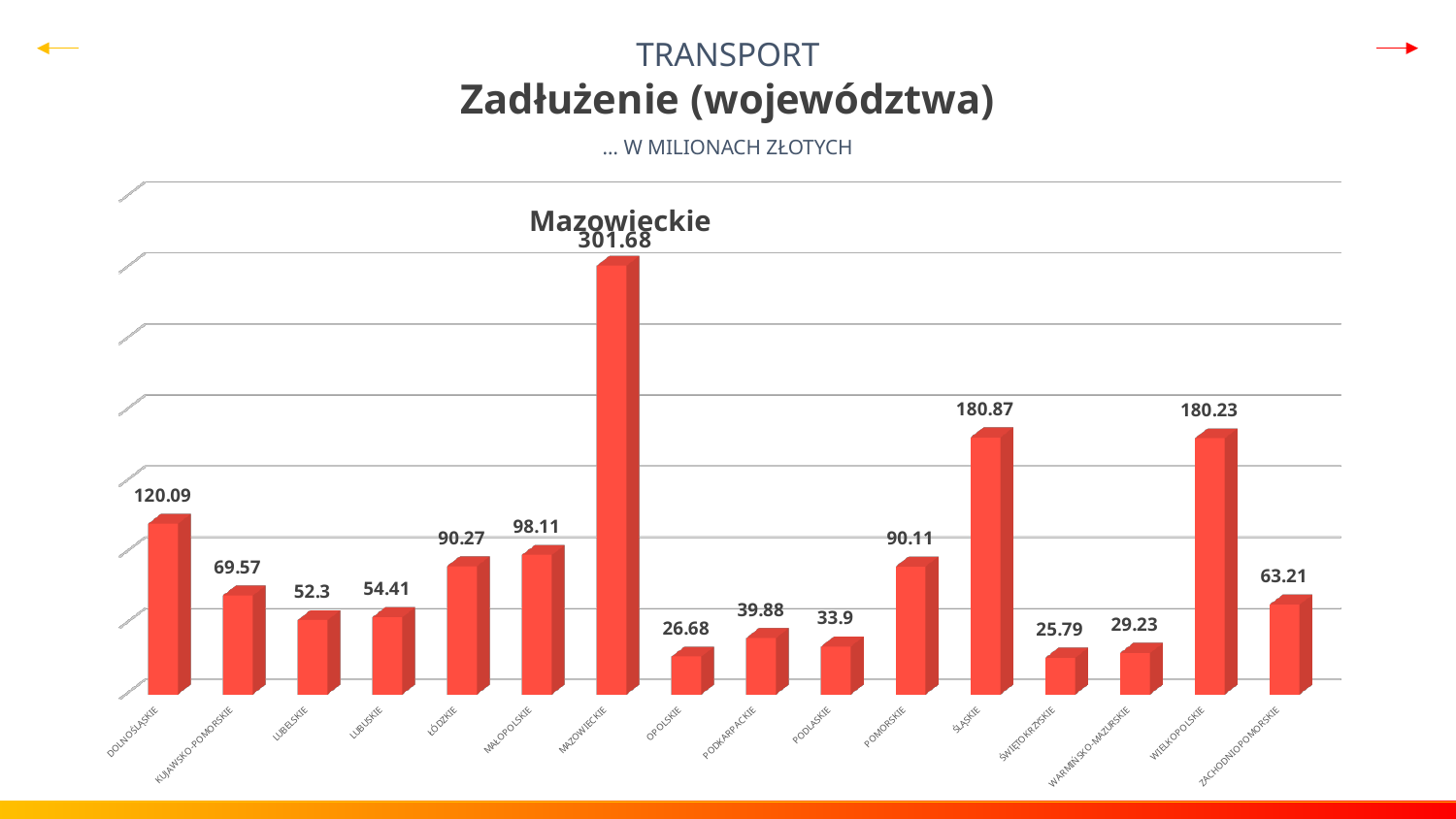
What is the difference between the values for Mazowieckie and Dolnośląskie? 181.59 What is the value for Wielkopolskie? 180.23 What kind of chart is shown on the slide? Bar chart How many voivodeships are shown on the chart? 16 Which voivodeship has the highest value? Mazowieckie What is the value for Dolnośląskie? 120.09 What is the difference between the values for Śląskie and Wielkopolskie? 0.64 Which voivodeship has the lowest value? Świętokrzyskie Which is larger, the value for Łódzkie or the value for Małopolskie? Małopolskie In what unit are the values on the chart expressed, according to the subtitle? Millions of złoty (w milionach złotych) What is the value for Opolskie? 26.68 What is the value for Mazowieckie? 301.68